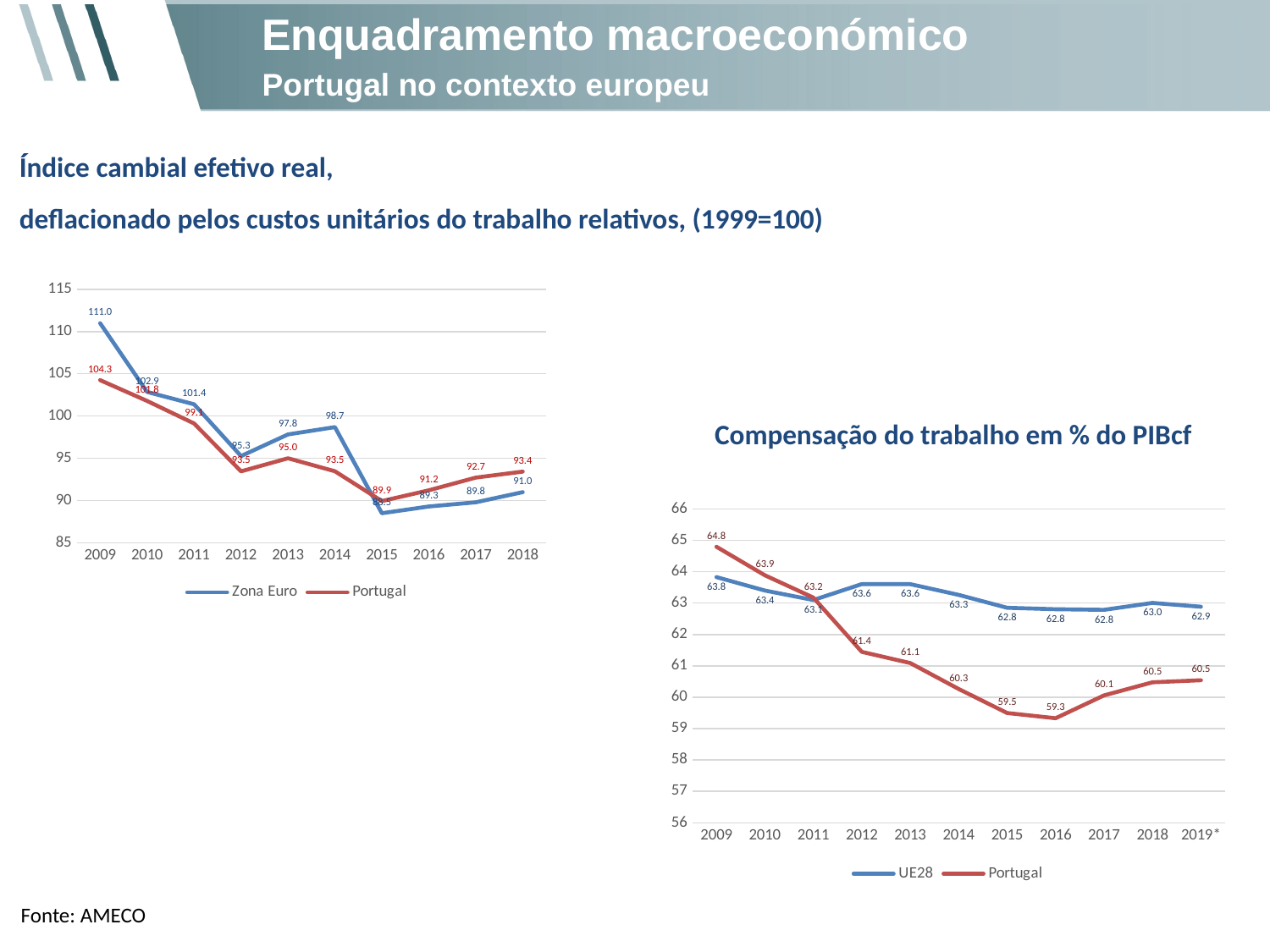
In the left chart (Índice cambial efetivo real), what is the value for Zona Euro in 2009? 111.0 In the left chart (Índice cambial efetivo real), which series has the higher value in 2017, Zona Euro or Portugal? Portugal In the left chart (Índice cambial efetivo real), what is the difference between Zona Euro and Portugal in 2018? 2.4 In the chart titled 'Compensação do trabalho em % do PIBcf', what is the value for Portugal in 2009? 64.8 In the left chart (Índice cambial efetivo real), in which year is the Zona Euro series highest? 2009 What type of chart is the chart titled 'Compensação do trabalho em % do PIBcf'? Line chart In the chart titled 'Compensação do trabalho em % do PIBcf', in which year is the Portugal series lowest? 2016 In the chart titled 'Compensação do trabalho em % do PIBcf', what is the value for UE28 in 2019*? 62.9 In the left chart (Índice cambial efetivo real), what is the value for Zona Euro in 2014? 98.7 In the chart titled 'Compensação do trabalho em % do PIBcf', how many years are shown on the x axis? 11 In the left chart (Índice cambial efetivo real), what is the value for Portugal in 2018? 93.4 In the chart titled 'Compensação do trabalho em % do PIBcf', how many series does the legend list? 2